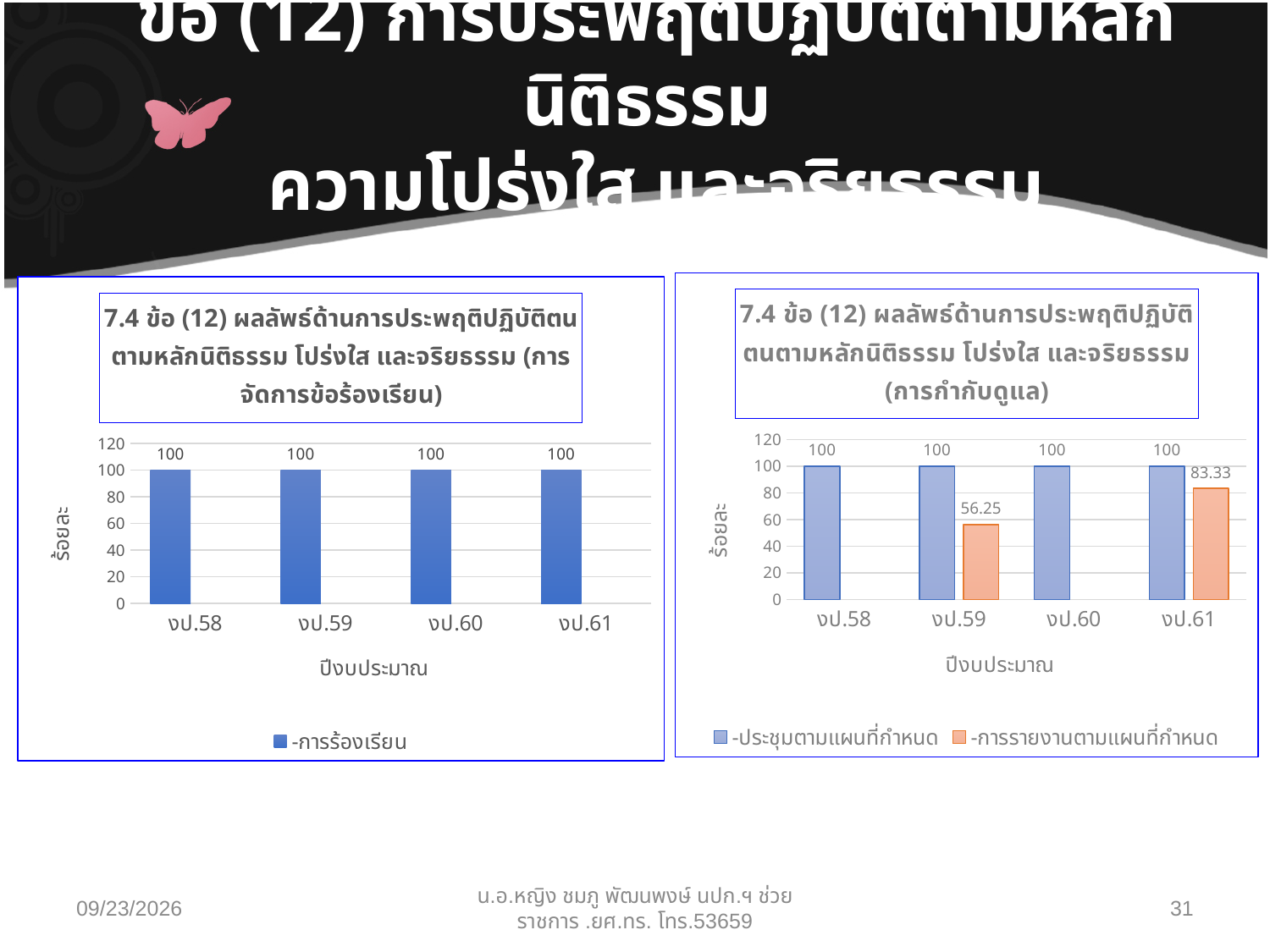
In the left chart (การจัดการข้อร้องเรียน), what kind of chart is it? bar chart In the left chart (การจัดการข้อร้องเรียน), how many years are shown on the x axis? 4 In the right chart (การกำกับดูแล), what is the value of -การรายงานตามแผนที่กำหนด for งป.61? 83.33 In the right chart (การกำกับดูแล), what is the label of the y axis? ร้อยละ In the right chart (การกำกับดูแล), what is the difference between -ประชุมตามแผนที่กำหนด and -การรายงานตามแผนที่กำหนด for งป.59? 43.75 In the right chart (การกำกับดูแล), what is the value of -การรายงานตามแผนที่กำหนด for งป.59? 56.25 In the left chart (การจัดการข้อร้องเรียน), how many series does the legend list? 1 In the left chart (การจัดการข้อร้องเรียน), do the values rise, fall or stay the same from งป.58 to งป.61? stay the same In the right chart (การกำกับดูแล), how many series does the legend list? 2 In the left chart (การจัดการข้อร้องเรียน), what is the value for งป.59? 100 In the right chart (การกำกับดูแล), what is the value of -ประชุมตามแผนที่กำหนด for งป.60? 100 In the right chart (การกำกับดูแล), which is larger for งป.61: -ประชุมตามแผนที่กำหนด or -การรายงานตามแผนที่กำหนด? -ประชุมตามแผนที่กำหนด